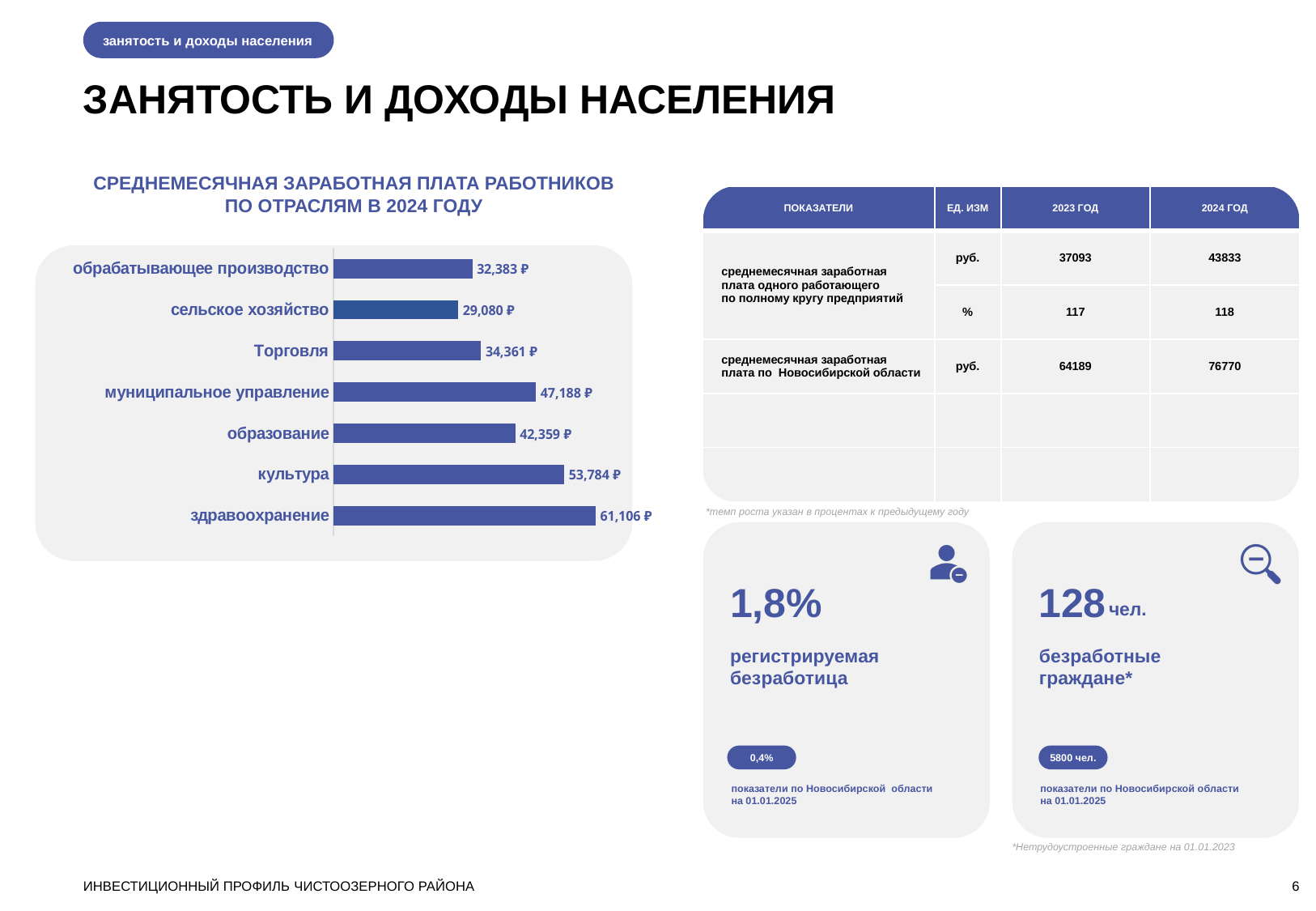
How many sectors are shown in the chart? 7 What value is shown for сельское хозяйство? 29,080 ₽ What is the title of the chart? СРЕДНЕМЕСЯЧНАЯ ЗАРАБОТНАЯ ПЛАТА РАБОТНИКОВ ПО ОТРАСЛЯМ В 2024 ГОДУ What is the difference between the values for Торговля and сельское хозяйство? 5,281 ₽ What is the value for муниципальное управление? 47,188 ₽ Which sector has the lowest average monthly salary in the chart? сельское хозяйство What is the average monthly salary shown for здравоохранение? 61,106 ₽ Which sector has the highest average monthly salary in the chart? здравоохранение What is the difference between the values for здравоохранение and культура? 7,322 ₽ What type of chart is used to show average monthly salaries by sector? Bar chart What value is labelled for образование? 42,359 ₽ Which is larger, the value for обрабатывающее производство or the value for Торговля? Торговля